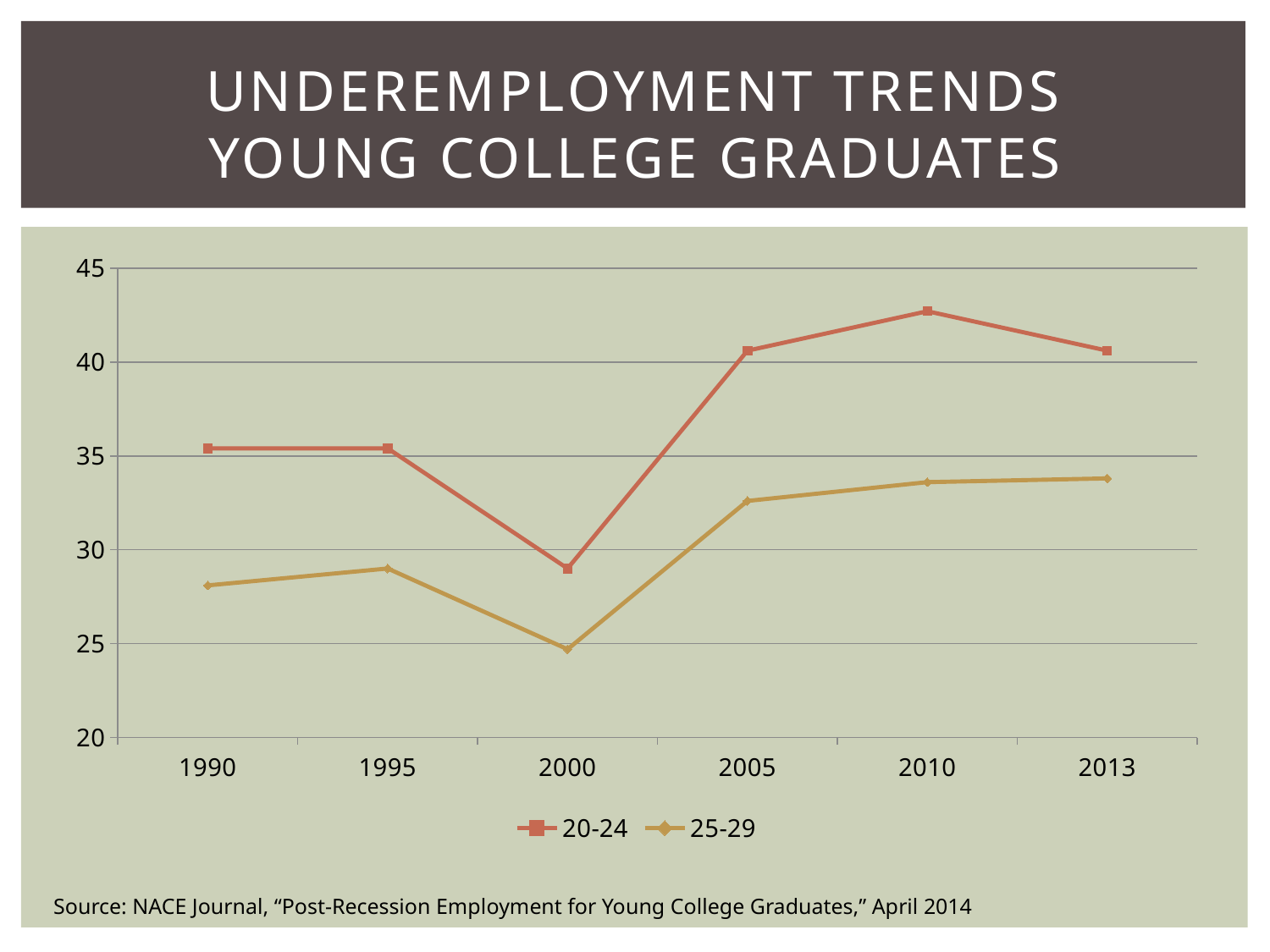
How many series does the legend list? 2 Is the value for the 20-24 series in 2000 greater or less than 30? less In 2005, which series has the higher value, 20-24 or 25-29? 20-24 In which year is the value for the 20-24 series lowest? 2000 What kind of chart is shown on the slide? line chart Does the 25-29 series rise or fall between 1995 and 2000? fall How many years are plotted along the x axis? 6 Does the 20-24 series rise or fall between 2000 and 2010? rise In which year is the value for the 20-24 series highest? 2010 In which year is the value for the 25-29 series lowest? 2000 Is the value for the 20-24 series in 2010 greater or less than 40? greater